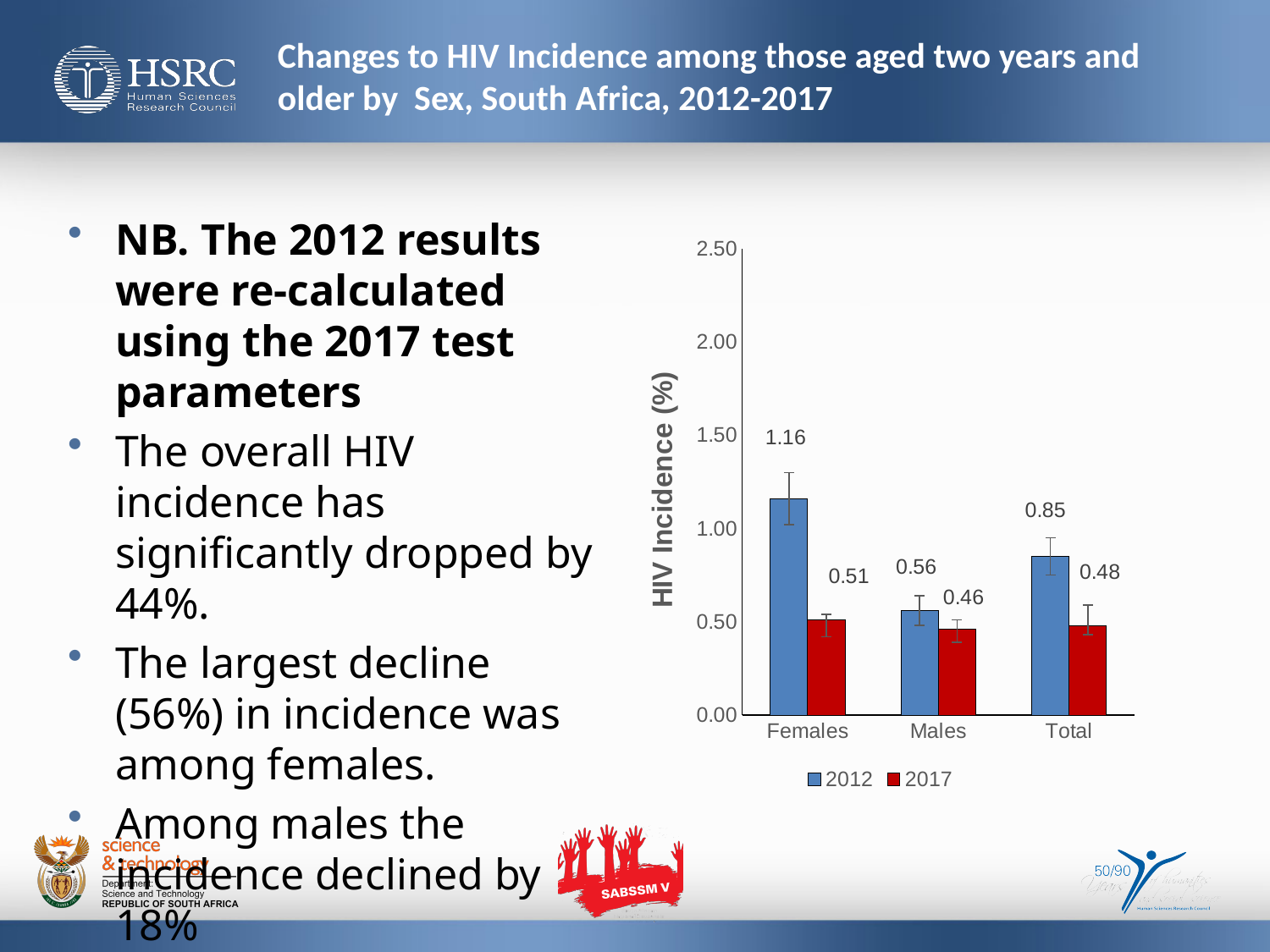
What is the HIV incidence for Males in 2017? 0.46 Which is larger, the 2012 HIV incidence for Males or the 2017 HIV incidence for Total? 2012 Males Which category has the highest HIV incidence in 2012? Females Which category has the lowest HIV incidence in 2017? Males What is the HIV incidence for Total in 2012? 0.85 What is the difference between the 2012 and 2017 HIV incidence for Females? 0.65 How many categories are shown on the x axis? 3 What is the HIV incidence for Females in 2012? 1.16 What type of chart is shown on the slide? bar chart Is the 2012 HIV incidence for Females greater or less than 1.00? greater What is the HIV incidence for Females in 2017? 0.51 How many series does the legend list? 2